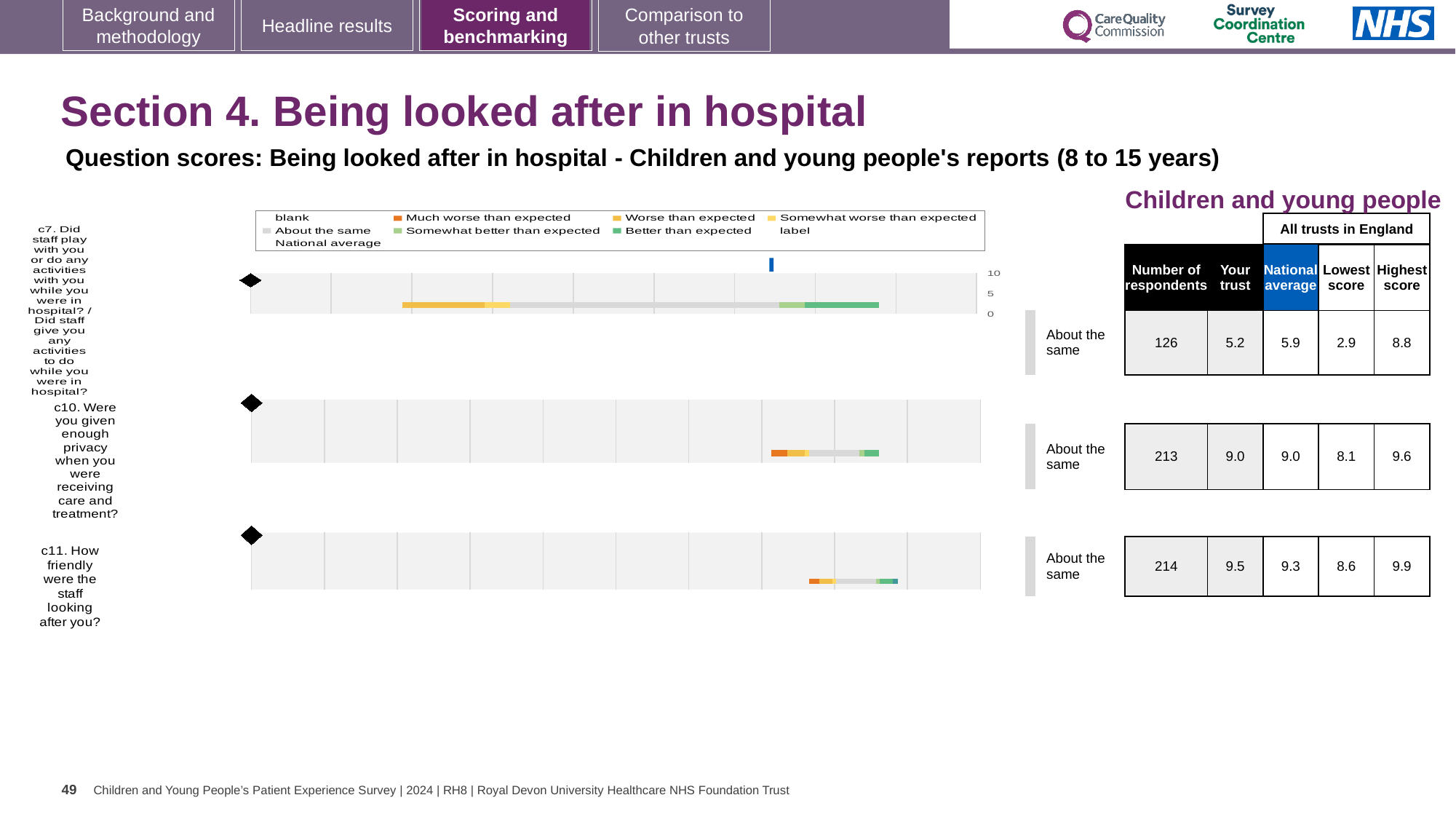
What is the 'Your trust' score for question c10 (Were you given enough privacy when you were receiving care and treatment?)? 9.0 What is the highest score across all trusts in England for question c11? 9.9 How many questions (rows) are plotted on this slide? 3 Which of the three questions shown has the highest number of respondents? c11 Which of the three questions shown has the lowest 'Your trust' score? c7 What kind of chart is used to show the benchmark ranges for each question? Bar chart For question c7, which is larger: the 'Your trust' score or the national average? National average What is the difference between the highest score and the lowest score across all trusts in England for question c7? 5.9 How many respondents answered question c11 (How friendly were the staff looking after you?)? 214 What benchmark category is shown for question c10? About the same What is the national average score for question c7 (Did staff play with you or do any activities with you while you were in hospital?)? 5.9 For question c11, is the 'Your trust' score higher or lower than the national average? higher